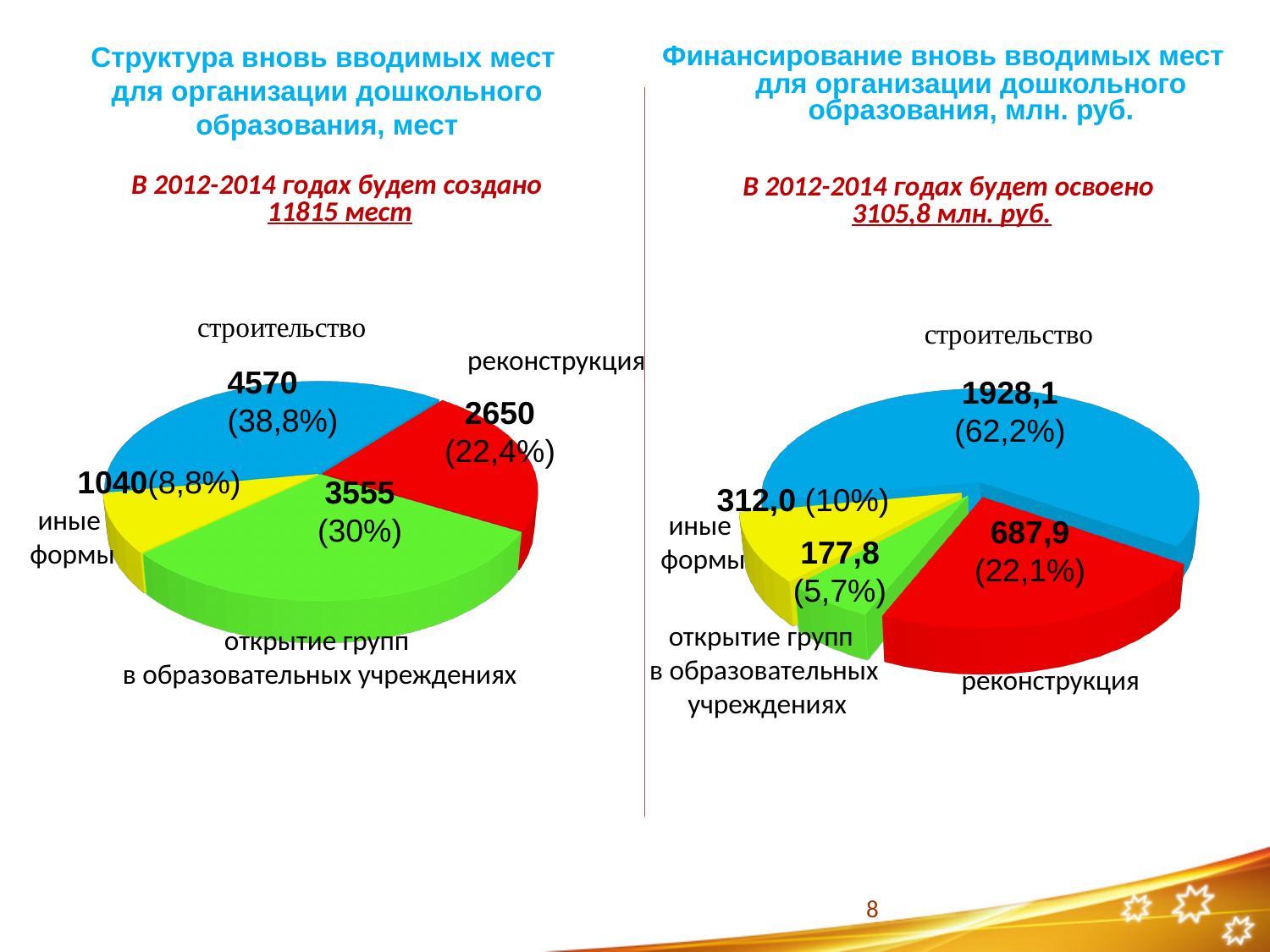
In the left pie chart, which category has the smallest slice? иные формы In the left pie chart, what is the difference between the values for строительство and открытие групп в образовательных учреждениях? 1015 In the right pie chart, what is the difference between the values for строительство and реконструкция? 1240,2 In the right pie chart, what share of the pie does строительство have? 62,2% In the right pie chart (Финансирование вновь вводимых мест), what value is shown for реконструкция? 687,9 In the right pie chart, which is larger: иные формы or открытие групп в образовательных учреждениях? иные формы What type of chart is used on the right side of the slide? pie chart In the left pie chart, what share of the pie does реконструкция have? 22,4% In the right pie chart, which category has the smallest slice? открытие групп в образовательных учреждениях In the left pie chart, which category has the largest slice? строительство How many slices does the left pie chart have? 4 In the left pie chart (Структура вновь вводимых мест), what value is shown for строительство? 4570